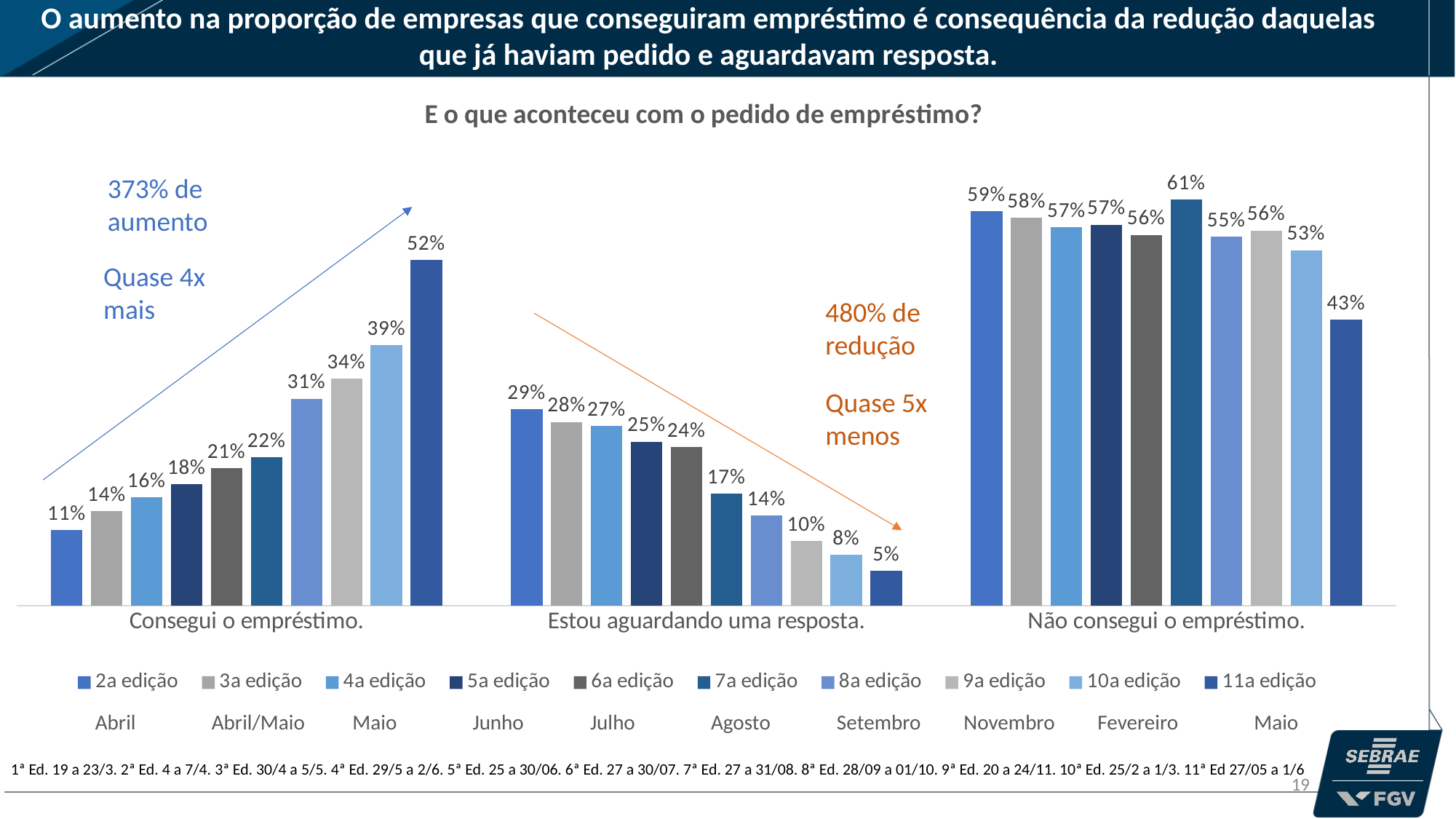
What is the value for 2a edição in the category "Estou aguardando uma resposta."? 29% How many categories are shown on the x axis? 3 What is the value for 11a edição in the category "Consegui o empréstimo."? 52% What kind of chart is shown on the slide? bar chart How many series does the legend list? 10 Do the values for "Estou aguardando uma resposta." rise or fall from 2a edição to 11a edição? fall What is the title of the chart? E o que aconteceu com o pedido de empréstimo? What is the difference between the 11a edição and 2a edição values in the category "Consegui o empréstimo."? 41% Which is larger in the category "Estou aguardando uma resposta.": the value for 6a edição or the value for 8a edição? 6a edição Which edition has the lowest value in the category "Estou aguardando uma resposta."? 11a edição Which edition has the highest value in the category "Não consegui o empréstimo."? 7a edição What is the value for 7a edição in the category "Não consegui o empréstimo."? 61%